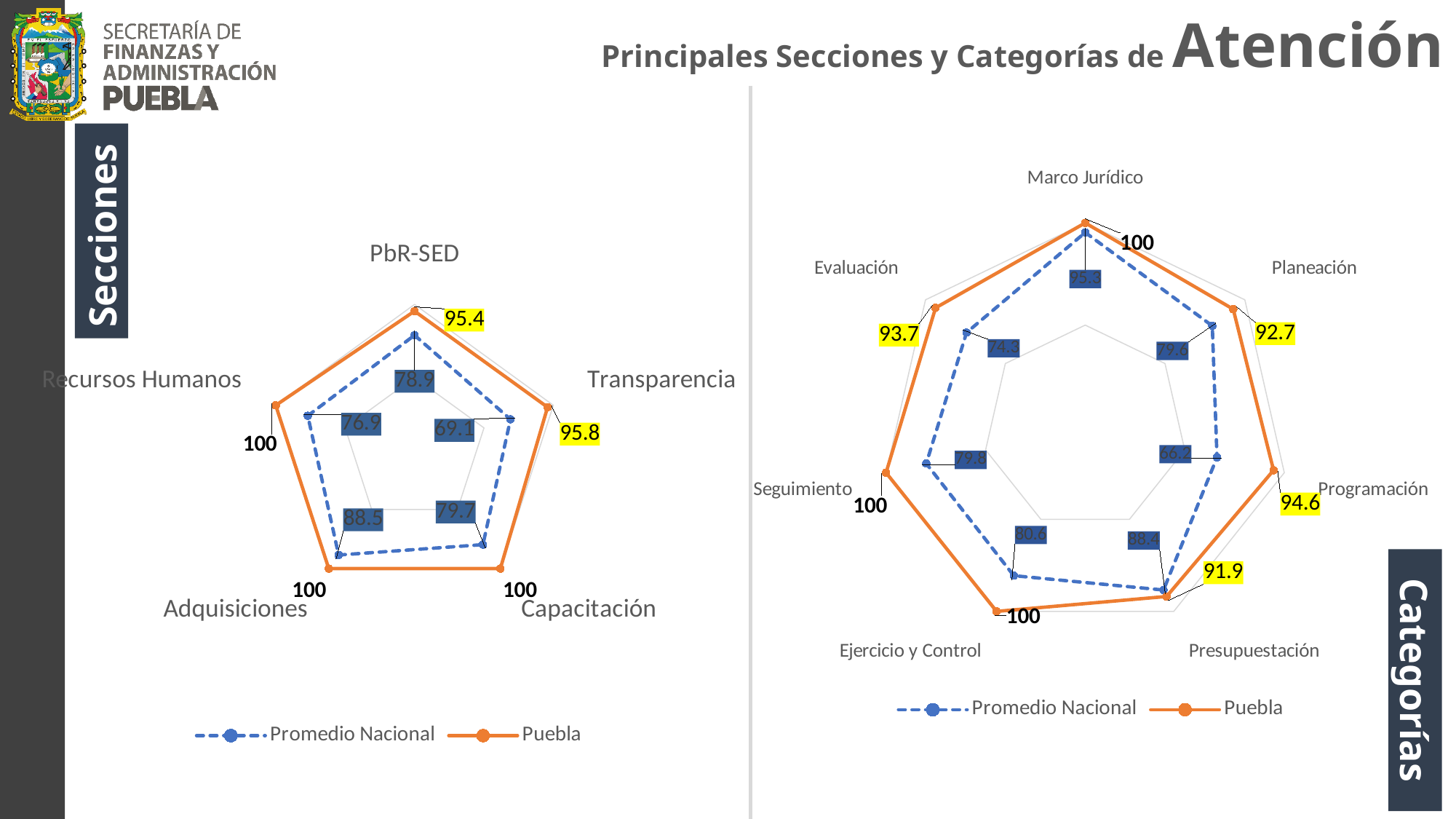
On the left chart (Secciones), what is the Promedio Nacional value for Transparencia? 69.1 On the left chart (Secciones), what is the difference between the Puebla and Promedio Nacional values for Transparencia? 26.7 On the right chart (Categorías), which category has the lowest Promedio Nacional value? Programación On the left chart (Secciones), how many categories are plotted? 5 On the left chart (Secciones), which category has the lowest Promedio Nacional value? Transparencia On the left chart (Secciones), what is the Promedio Nacional value for Adquisiciones? 88.5 On the right chart (Categorías), which is larger for Evaluación: the Puebla value or the Promedio Nacional value? Puebla On the right chart (Categorías), how many categories are plotted? 7 On the right chart (Categorías), what is the Promedio Nacional value for Marco Jurídico? 95.3 On the right chart (Categorías), what is the Puebla value for Programación? 94.6 On the left chart (Secciones), what is the Puebla value for PbR-SED? 95.4 What type of chart is used on the left side of the slide (Secciones)? Radar chart